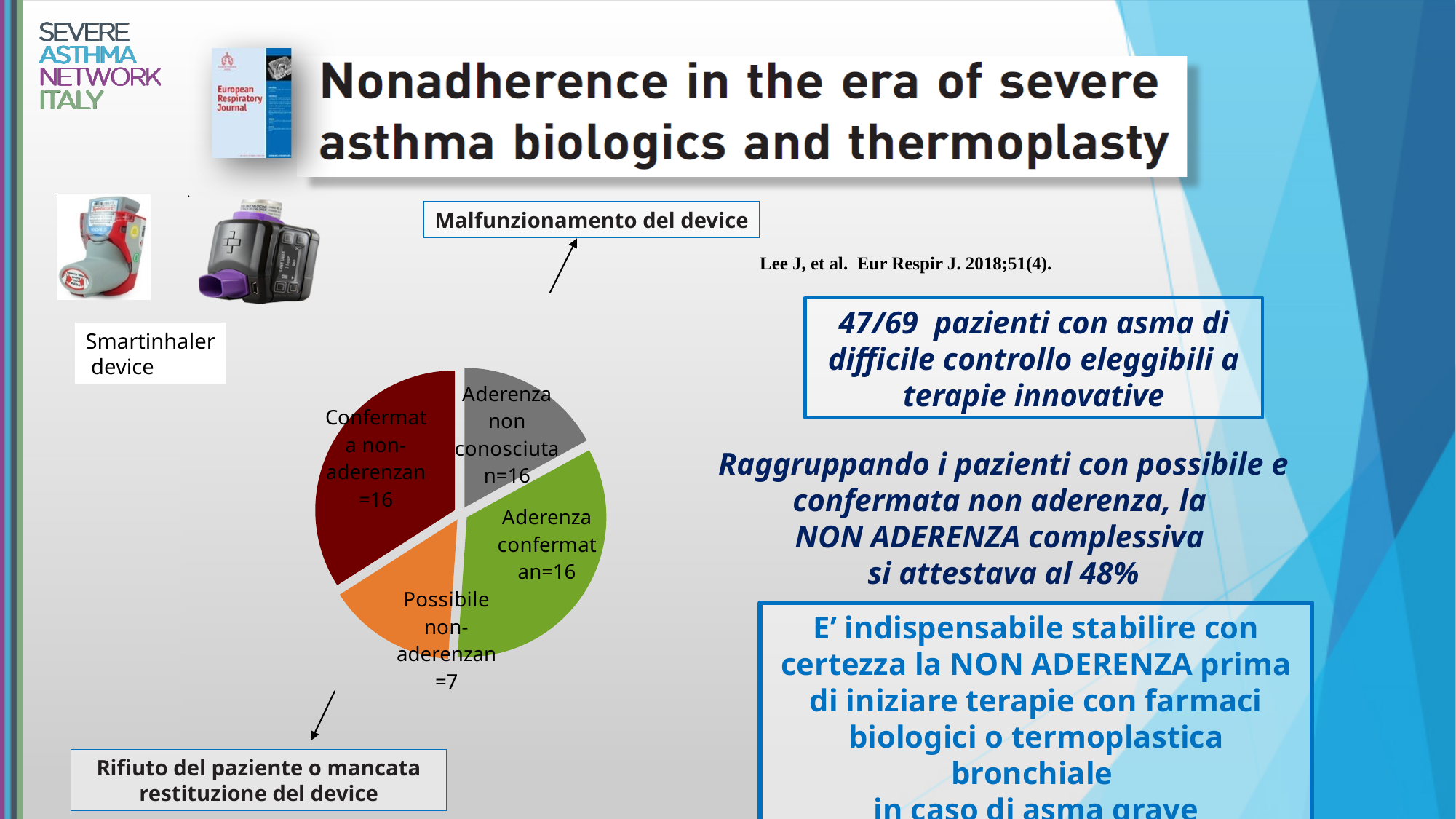
What kind of chart is shown on the slide? pie chart What colour is the 'Possibile non-aderenza' slice in the pie chart? orange How many slices does the pie chart have? 4 What is the value shown for the 'Possibile non-aderenza' slice of the pie chart? n=7 Which is larger in the pie chart: 'Confermata non-aderenza' or 'Possibile non-aderenza'? Confermata non-aderenza What is the difference between the 'Aderenza confermata' value and the 'Possibile non-aderenza' value in the pie chart? 9 What is the value shown for the 'Aderenza non conosciuta' slice of the pie chart? n=16 Which slice of the pie chart has the smallest value? Possibile non-aderenza What is the value shown for the 'Aderenza confermata' slice of the pie chart? n=16 What is the value shown for the 'Confermata non-aderenza' slice of the pie chart? n=16 What colour is the 'Aderenza confermata' slice in the pie chart? green